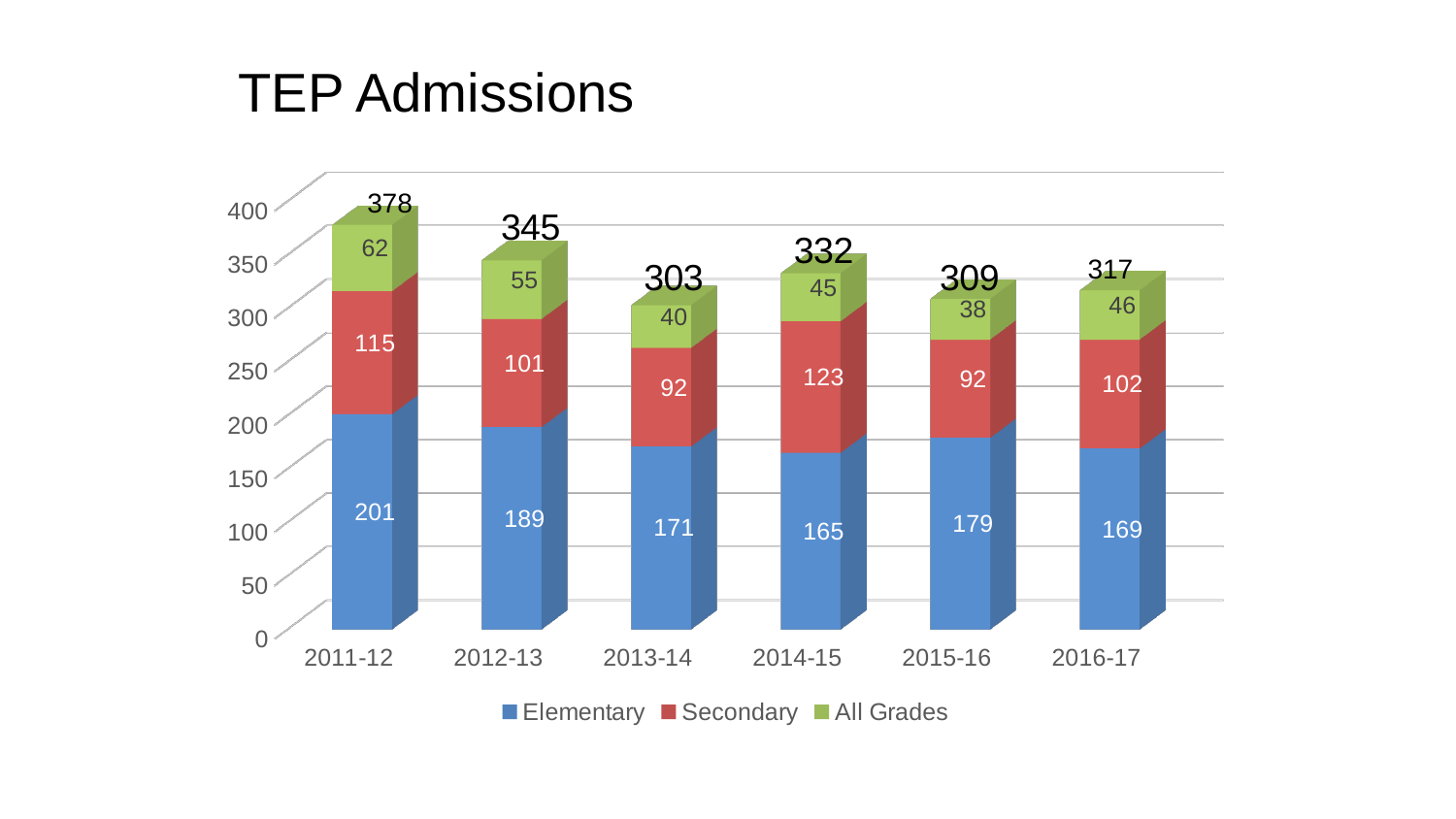
What kind of chart is shown? Stacked bar chart How many series does the legend list? 3 What is the total of the stacked bar for 2012-13? 345 Which is larger, the Secondary value for 2012-13 or the Secondary value for 2016-17? 2016-17 What is the Elementary value for 2011-12? 201 Which year has the highest total admissions? 2011-12 What is the difference between the Elementary values for 2011-12 and 2016-17? 32 What is the Secondary value for 2014-15? 123 What is the title of the chart? TEP Admissions How many years are shown on the x axis? 6 What is the All Grades value for 2015-16? 38 Which year has the lowest total admissions? 2013-14